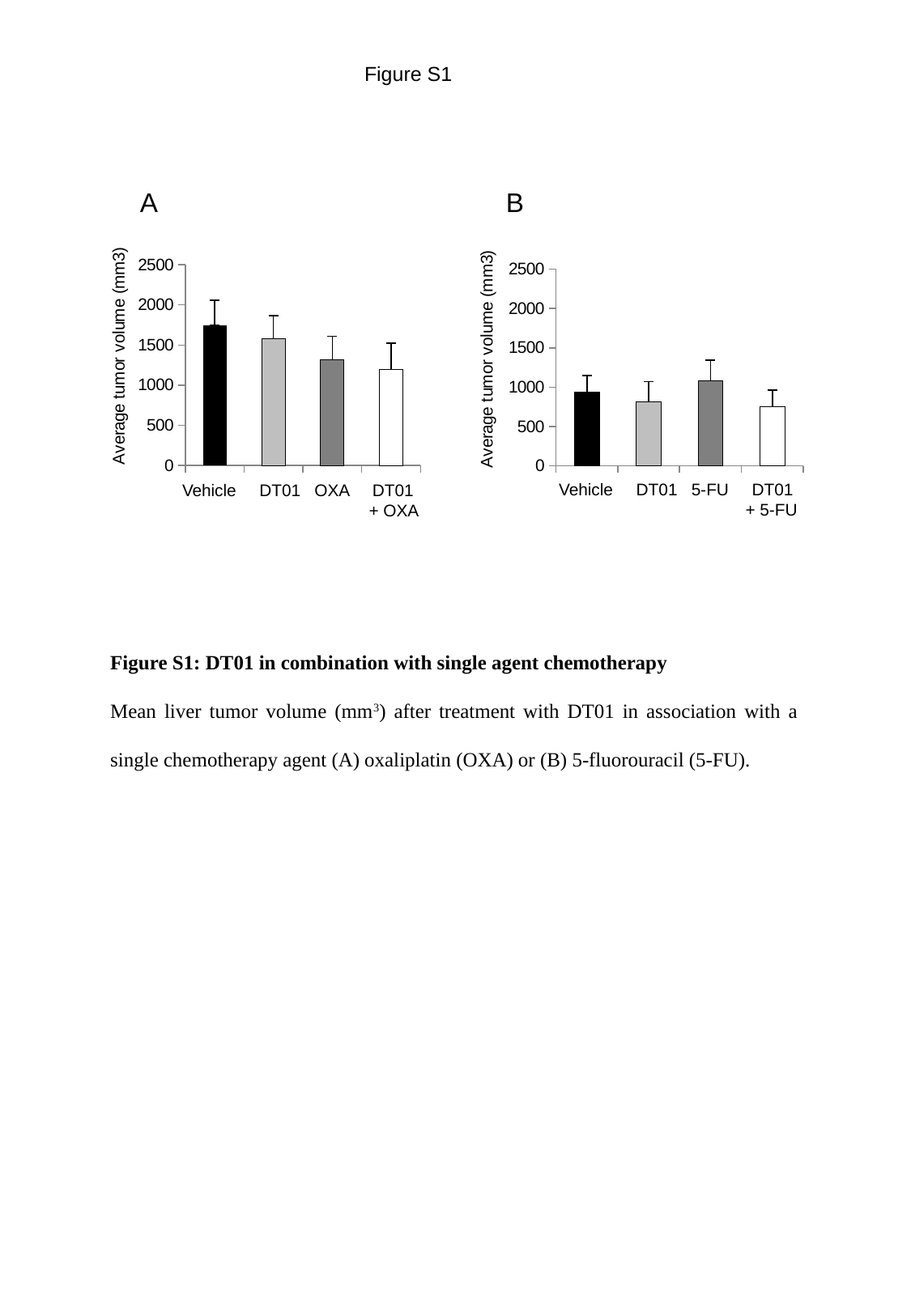
What is the y-axis label of chart B? Average tumor volume (mm3) In chart A, which is larger, the value for Vehicle or the value for OXA? Vehicle In chart B, which category has the lowest average tumor volume? DT01 + 5-FU How many categories are shown on the x axis of chart B? 4 What kind of chart is chart A? bar chart In chart A, do the bar values rise or fall from left to right along the x axis? fall How many categories are shown on the x axis of chart A? 4 In chart A, is the value for Vehicle greater or less than 1500? greater In chart A, which category has the lowest average tumor volume? DT01 + OXA In chart A, which category has the highest average tumor volume? Vehicle In chart B, is the value for DT01 + 5-FU greater or less than 1000? less In chart B, which category has the highest average tumor volume? 5-FU